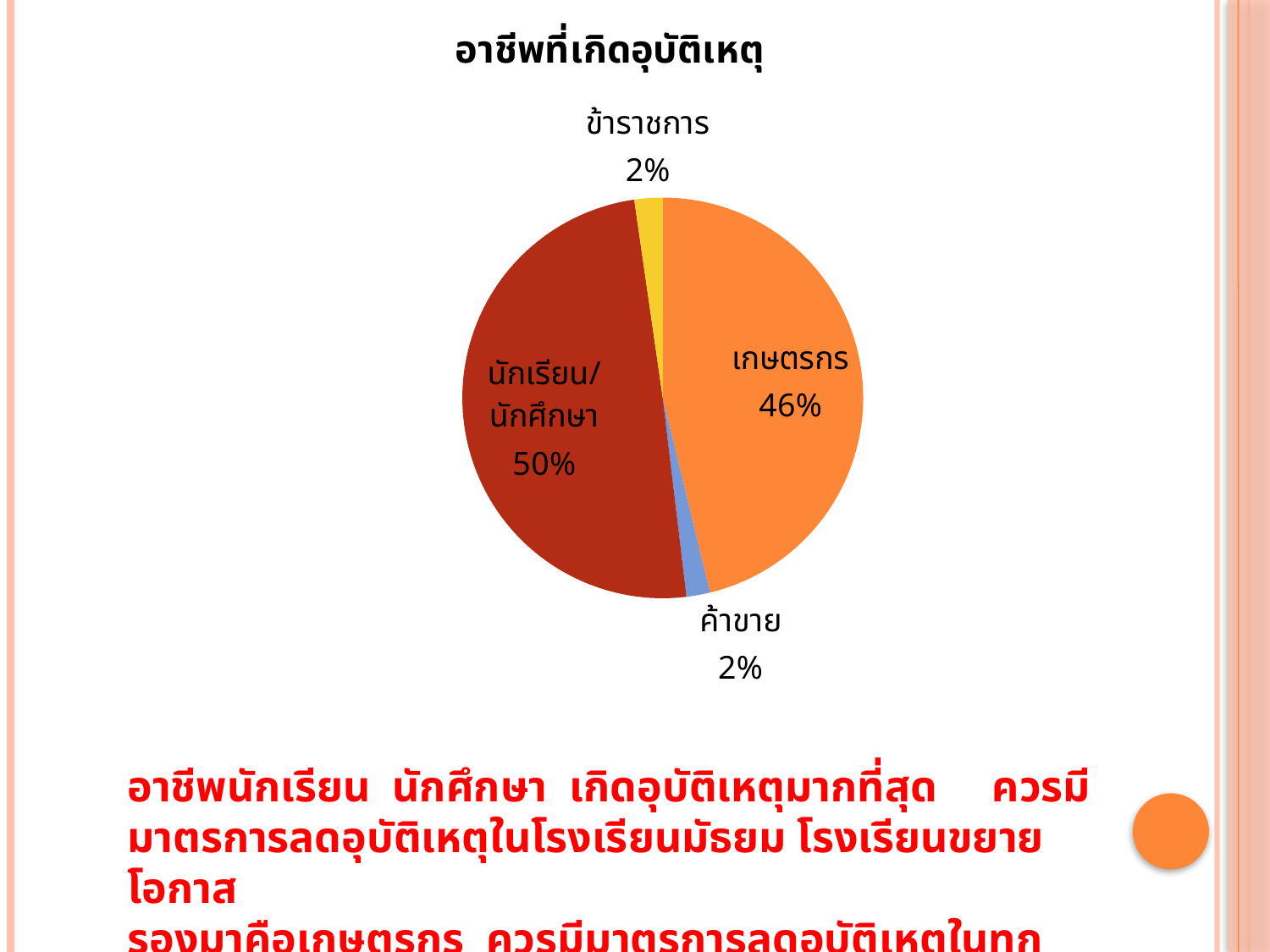
What colour is the เกษตรกร slice? Orange Which slice is larger, เกษตรกร or นักเรียน/นักศึกษา? นักเรียน/นักศึกษา How many categories are shown in the pie chart? 4 What percentage of the pie is the ข้าราชการ slice? 2% What is the title of the chart? อาชีพที่เกิดอุบัติเหตุ What type of chart is shown on the slide? Pie chart What is the difference in percentage points between the นักเรียน/นักศึกษา slice and the เกษตรกร slice? 4 percentage points What percentage of the pie is the เกษตรกร slice? 46% Which category has the largest share of the pie? นักเรียน/นักศึกษา What percentage of the pie is the ค้าขาย slice? 2% Which two categories share the smallest slice of the pie? ข้าราชการ and ค้าขาย What percentage of the pie is the นักเรียน/นักศึกษา slice? 50%